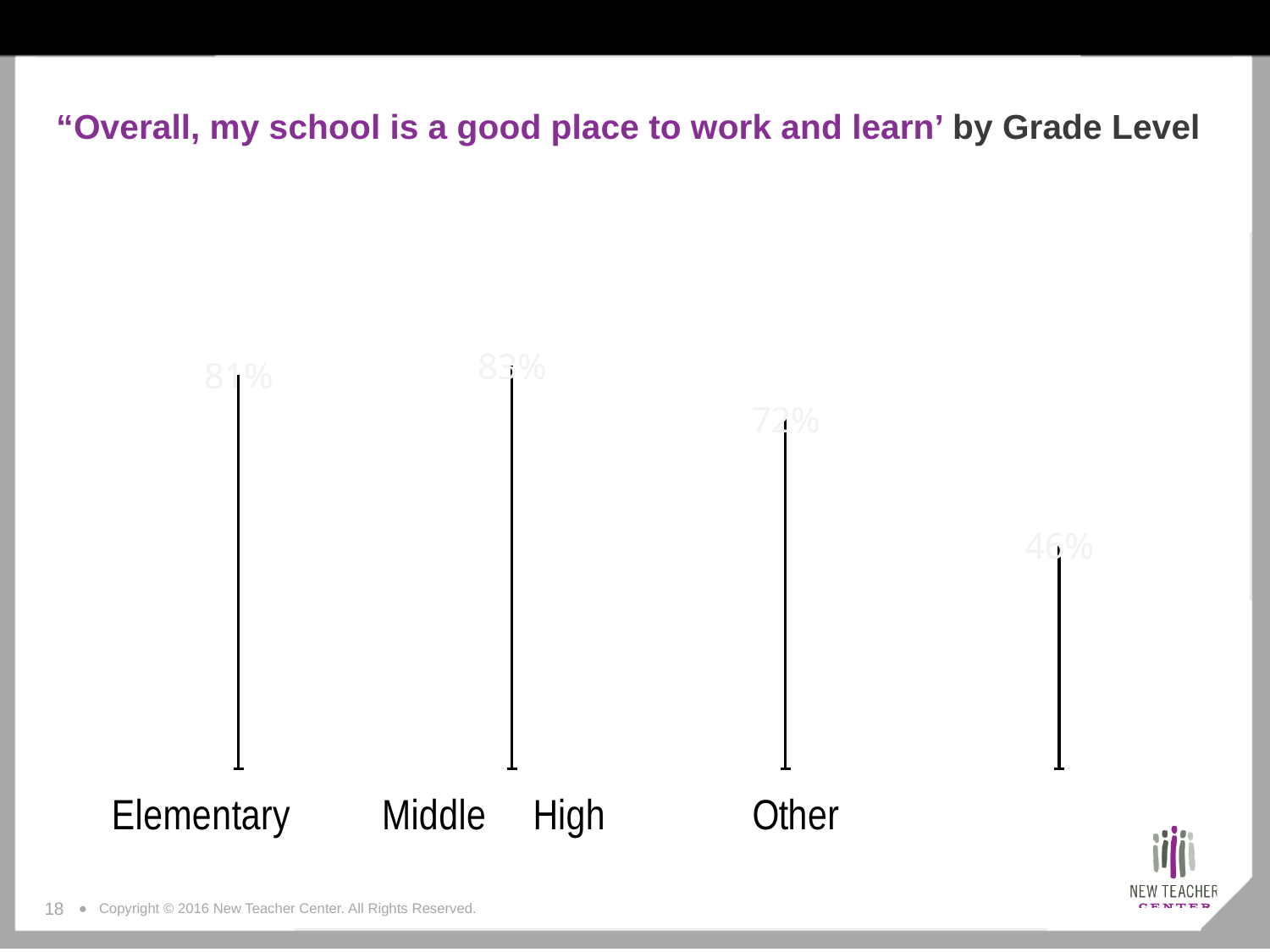
What survey statement does the chart title say the results are for? "Overall, my school is a good place to work and learn" What is the difference between the Elementary value and the Middle value? 2 percentage points How many bars are plotted in the chart? 4 Which is larger, the value for the leftmost bar (81%) or the value for the third bar (72%)? the leftmost bar (81%) Which bar has the highest value? Middle (83%) What is the value shown for the leftmost bar (Elementary)? 81% What is the value shown for the second bar from the left (Middle)? 83% Which bar has the lowest value? Other (46%) What is the value shown for the rightmost bar (Other)? 46% What kind of chart is shown on the slide? bar chart What is the value shown for the third bar from the left (High)? 72% What is the difference between the highest value (83%) and the lowest value (46%)? 37 percentage points